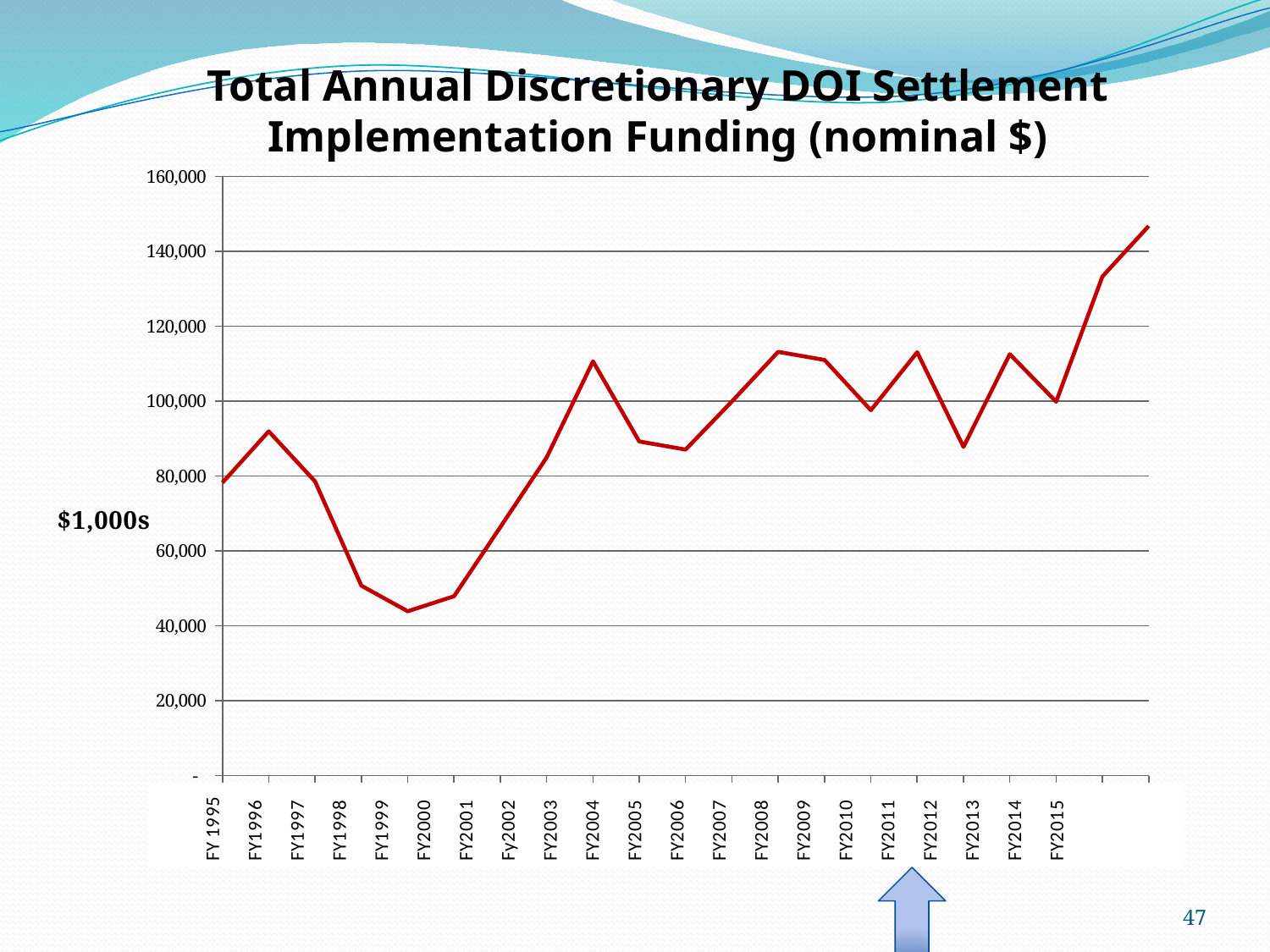
Is the value for FY2014 greater or less than 100,000? greater Which has the larger value, FY1999 or FY2003? FY2003 Is the value for FY1999 greater or less than 60,000? less What unit label is shown on the vertical axis of the chart? $1,000s What kind of chart is shown on the slide? line chart What is the title of the chart? Total Annual Discretionary DOI Settlement Implementation Funding (nominal $) Is the value for FY2000 greater or less than 60,000? less Do the values rise or fall from FY2000 to FY2003? rise Do the values rise or fall from FY1996 to FY1999? fall How many fiscal years are labeled on the x axis of the chart? 21